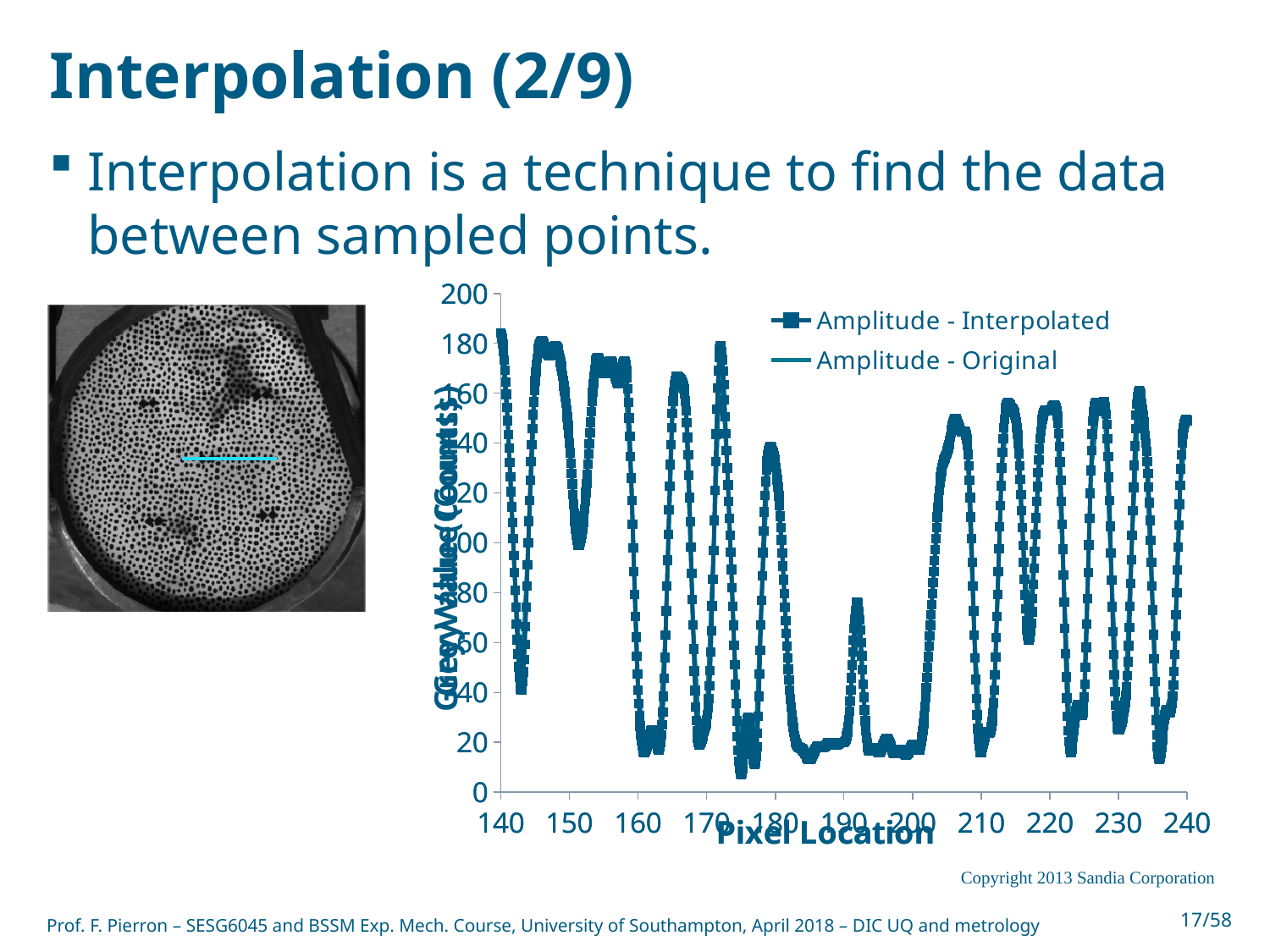
Is the value at pixel location 200 greater or less than 40? less What kind of chart is shown on the slide? line chart Is the value at pixel location 180 greater or less than 40? greater What is the title of the chart's x axis? Pixel Location Is the value at pixel location 190 greater or less than 60? less How many tick labels are shown on the chart's x axis? 11 How many series does the chart legend list? 2 What are the two series named in the chart legend? Amplitude - Interpolated and Amplitude - Original Does the value rise or fall between pixel location 140 and pixel location 142? fall What is the highest value shown on the chart's y axis? 200